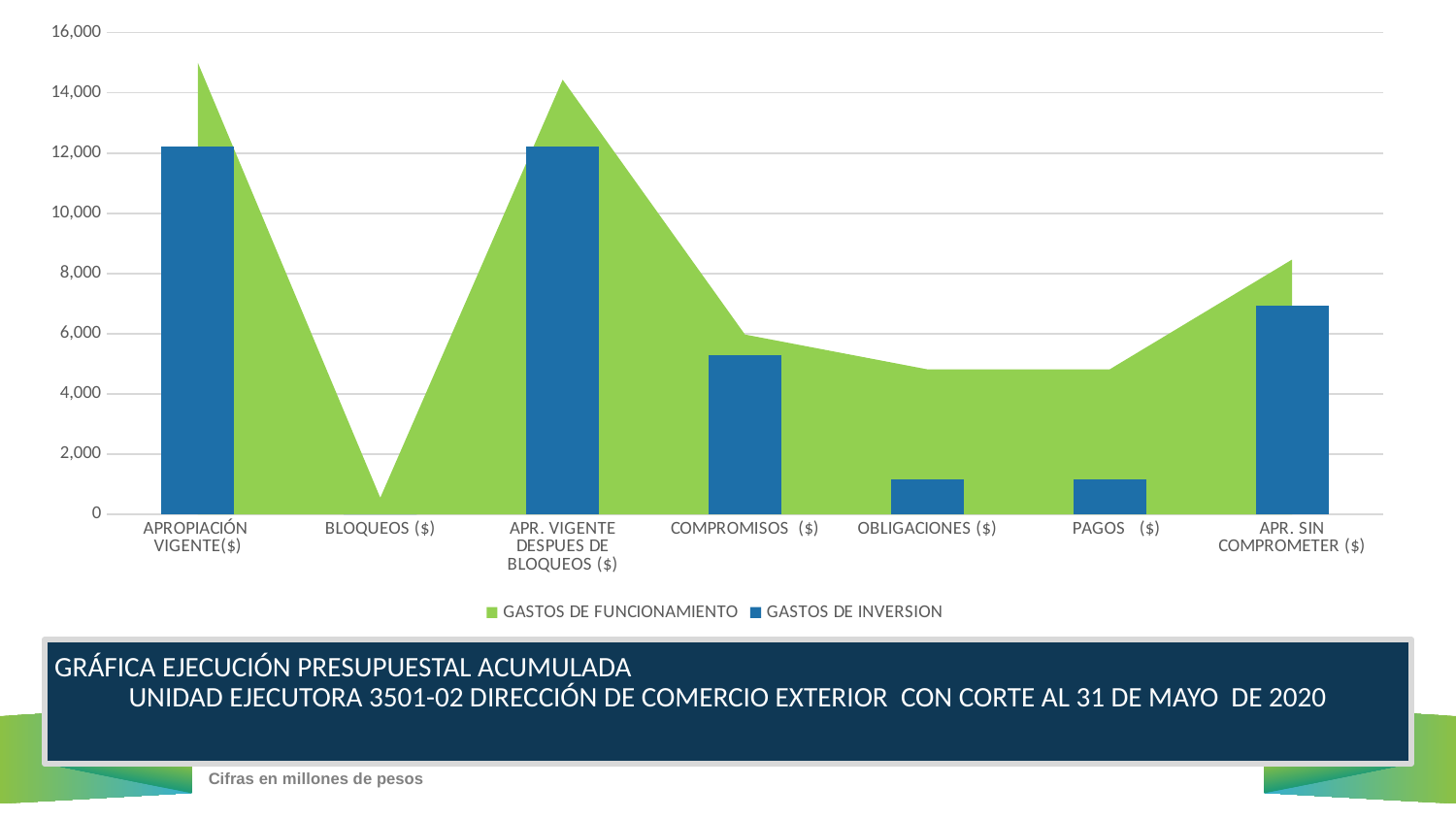
Which category has the lowest value for GASTOS DE FUNCIONAMIENTO? BLOQUEOS ($) What kind of chart is shown on the slide? A combined area and bar chart Which category has the highest value for GASTOS DE FUNCIONAMIENTO? APROPIACIÓN VIGENTE($) Is the GASTOS DE INVERSION value for PAGOS ($) greater or less than 2,000? less How many categories are shown on the x axis of the chart? 7 Which colour represents GASTOS DE INVERSION in the chart? Blue For OBLIGACIONES ($), which series has the larger value, GASTOS DE FUNCIONAMIENTO or GASTOS DE INVERSION? GASTOS DE FUNCIONAMIENTO How many series does the chart legend list? 2 Is the GASTOS DE FUNCIONAMIENTO value for OBLIGACIONES ($) greater or less than 4,000? greater Is the GASTOS DE INVERSION value for COMPROMISOS ($) greater or less than 6,000? less Does the GASTOS DE FUNCIONAMIENTO value rise or fall from PAGOS ($) to APR. SIN COMPROMETER ($)? rise